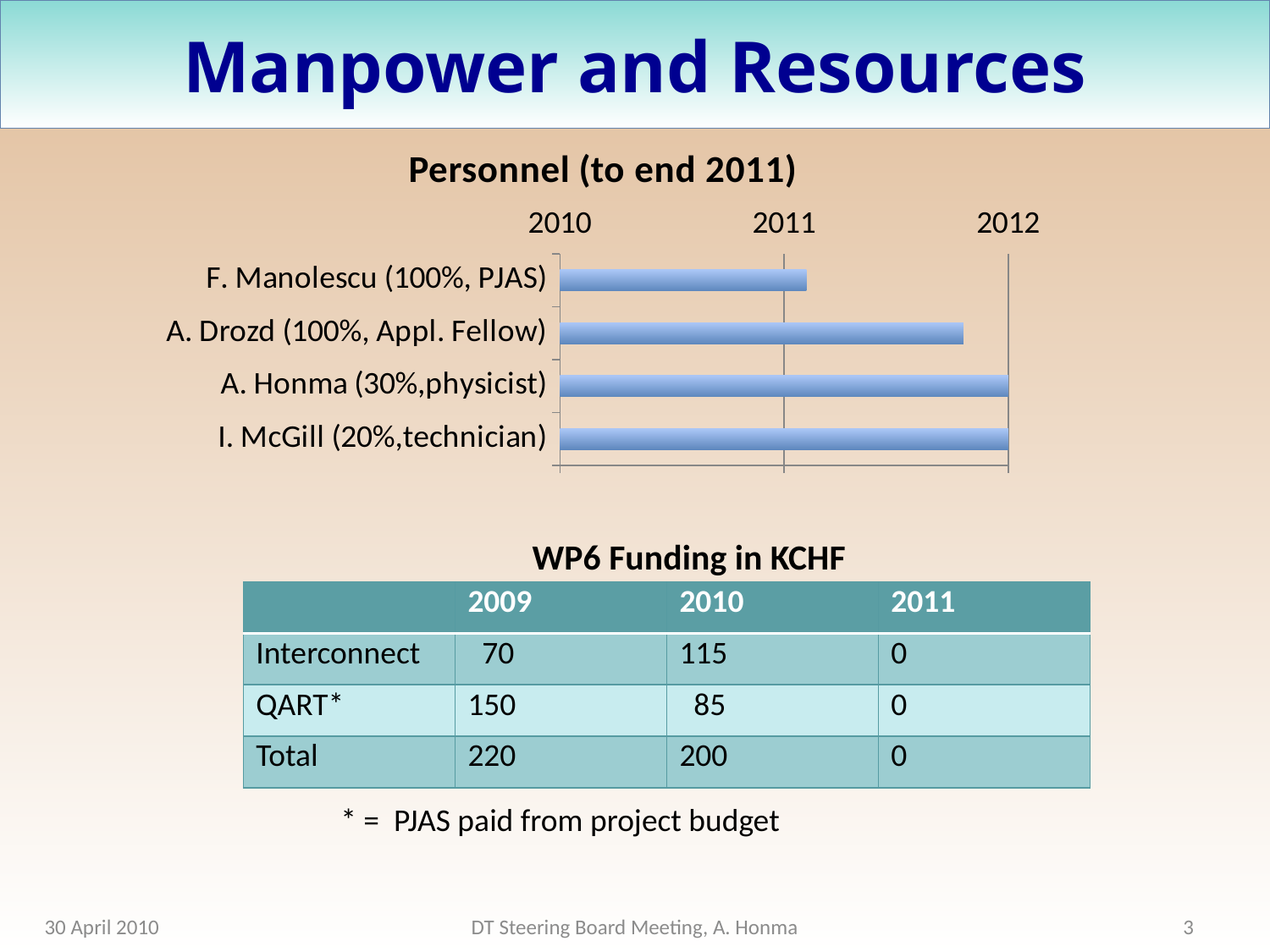
In the Personnel (to end 2011) chart, which person has the shortest bar? F. Manolescu (100%, PJAS) In the Personnel (to end 2011) chart, which category is listed at the bottom? I. McGill (20%,technician) In the Personnel (to end 2011) chart, whose bar extends further: A. Drozd (100%, Appl. Fellow) or F. Manolescu (100%, PJAS)? A. Drozd (100%, Appl. Fellow) In the Personnel (to end 2011) chart, whose bar extends further: I. McGill (20%,technician) or F. Manolescu (100%, PJAS)? I. McGill (20%,technician) In the Personnel (to end 2011) chart, does the bar for A. Drozd (100%, Appl. Fellow) end before or after 2011? after What kind of chart is shown under the title "Personnel (to end 2011)"? bar chart In the Personnel (to end 2011) chart, does the bar for F. Manolescu (100%, PJAS) end before or after 2012? before In the Personnel (to end 2011) chart, does the bar for A. Drozd (100%, Appl. Fellow) end before or after 2012? before What is the title of the bar chart on the slide? Personnel (to end 2011) What years are shown as tick labels on the horizontal axis of the Personnel (to end 2011) chart? 2010, 2011, 2012 How many personnel categories are plotted in the Personnel (to end 2011) chart? 4